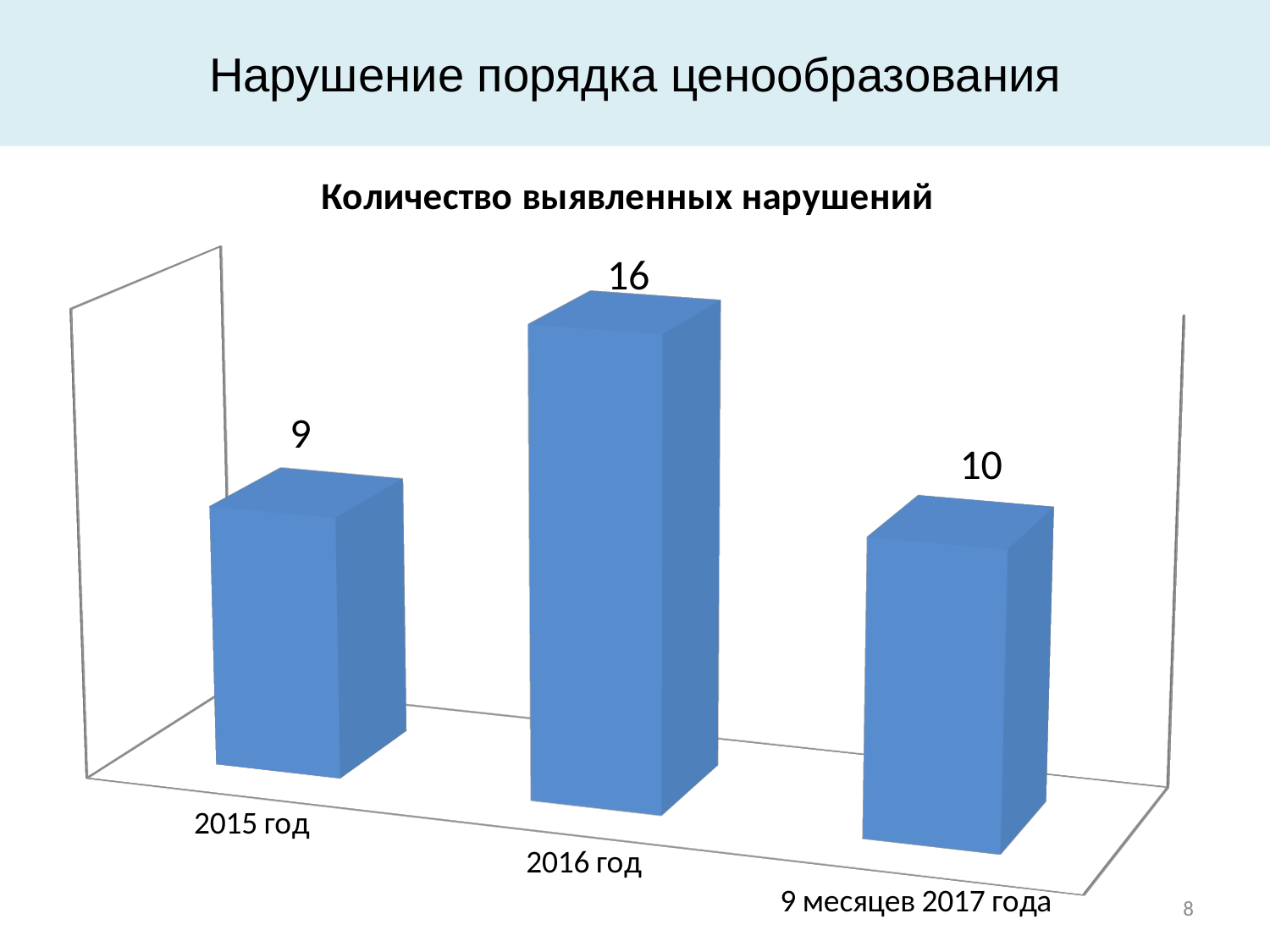
Which is larger, the value for 2015 год or the value for 9 месяцев 2017 года? 9 месяцев 2017 года Which category has the lowest value? 2015 год What is the title of the chart? Количество выявленных нарушений What is the value for 9 месяцев 2017 года? 10 How many categories are shown in the chart? 3 What is the difference between the values for 2016 год and 2015 год? 7 Which category has the highest value? 2016 год What is the difference between the values for 2016 год and 9 месяцев 2017 года? 6 What kind of chart is shown on the slide? bar chart What is the value for 2015 год? 9 What is the value for 2016 год? 16 What is the total of all three values shown in the chart? 35